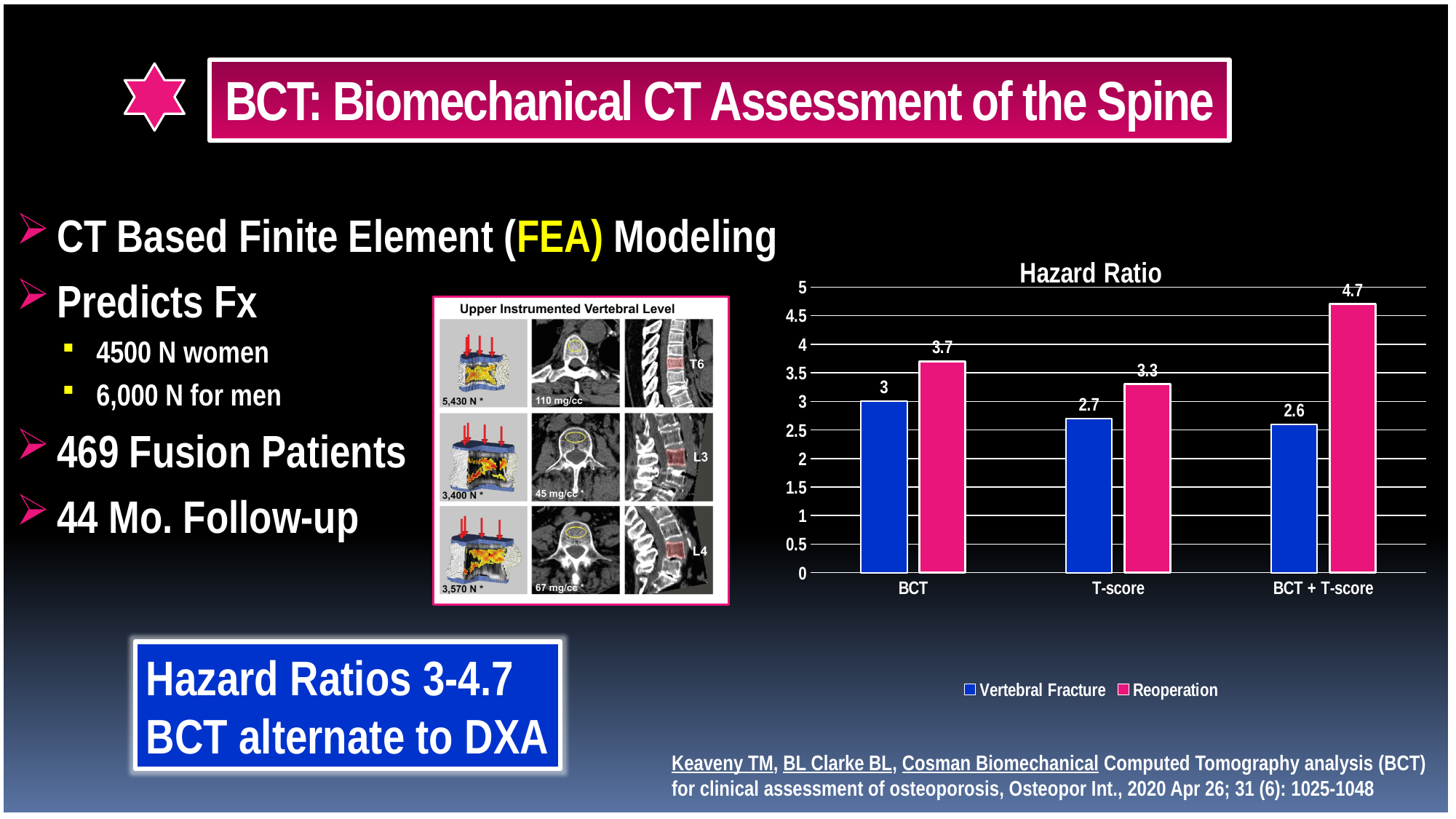
What is the Vertebral Fracture hazard ratio for BCT? 3 What is the difference between the Reoperation and Vertebral Fracture hazard ratios for BCT + T-score? 2.1 What is the Reoperation hazard ratio for BCT + T-score? 4.7 Which category has the highest Reoperation hazard ratio? BCT + T-score What kind of chart is the Hazard Ratio chart? Bar chart Which is larger for T-score: the Vertebral Fracture or the Reoperation hazard ratio? Reoperation Which category has the lowest Vertebral Fracture hazard ratio? BCT + T-score What is the Vertebral Fracture hazard ratio for BCT + T-score? 2.6 How many series does the legend of the Hazard Ratio chart list? 2 What is the title of the chart on the slide? Hazard Ratio What is the Reoperation hazard ratio for T-score? 3.3 How many categories are shown on the x axis of the Hazard Ratio chart? 3